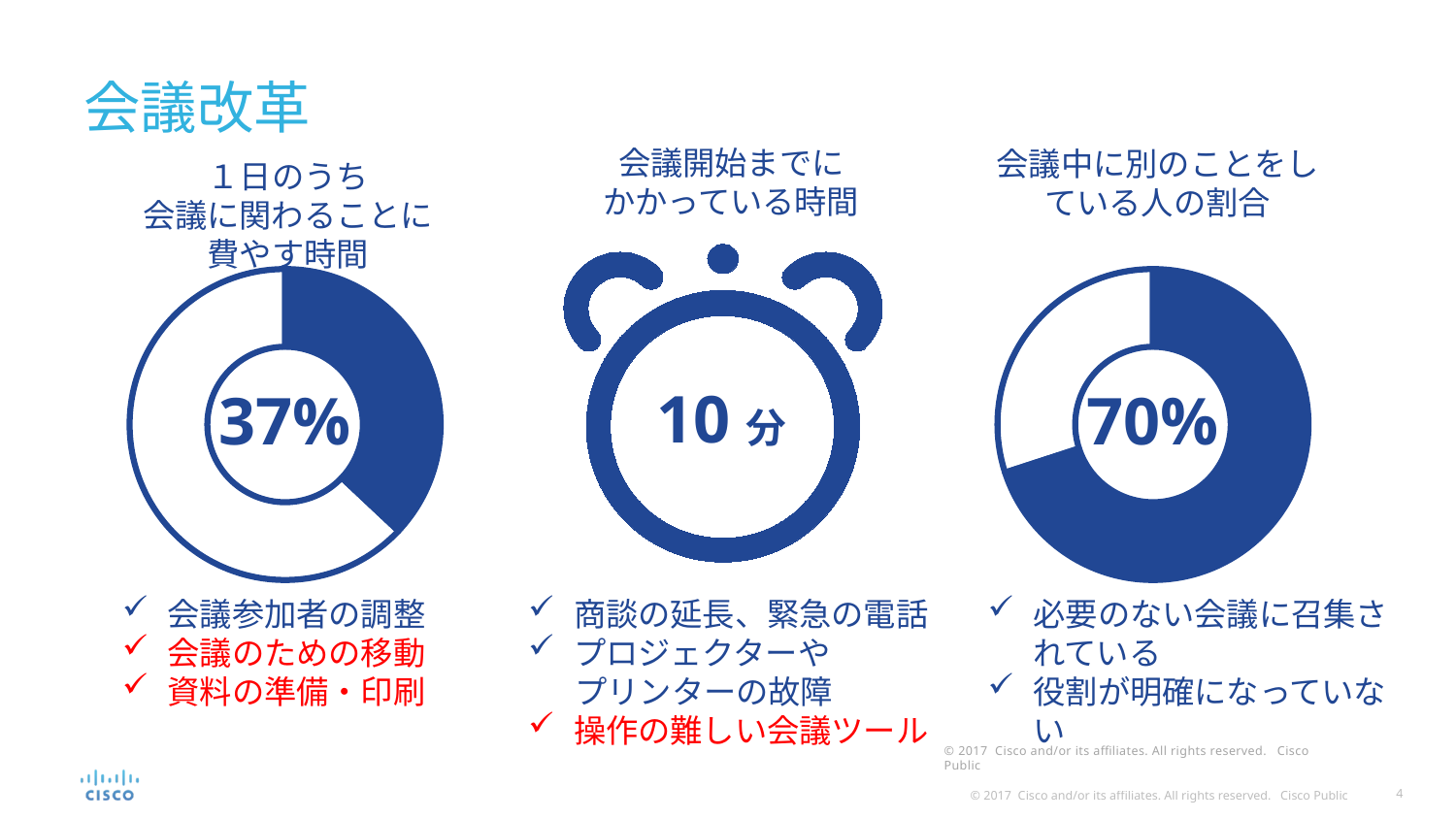
Is the value shown on the right donut chart greater or less than 50%? greater What is the difference in percentage points between the right donut chart's value and the left donut chart's value? 33 percentage points Which donut chart shows the larger percentage, the left one (37%) or the right one (70%)? The right one (70%) On the right donut chart, what share of the ring is filled in dark blue? 70% On the right donut chart (会議中に別のことをしている人の割合), what percentage is shown in the centre? 70% What kind of chart is used on the right of the slide to show the 70% value? Donut chart Is the value shown on the left donut chart greater or less than 50%? less What is the title above the right donut chart? 会議中に別のことをしている人の割合 On the left donut chart (１日のうち会議に関わることに費やす時間), what percentage is shown in the centre? 37% How many donut charts are on the slide? 2 What kind of chart is used on the left of the slide to show the 37% value? Donut chart On the left donut chart, what share of the ring is filled in dark blue? 37%